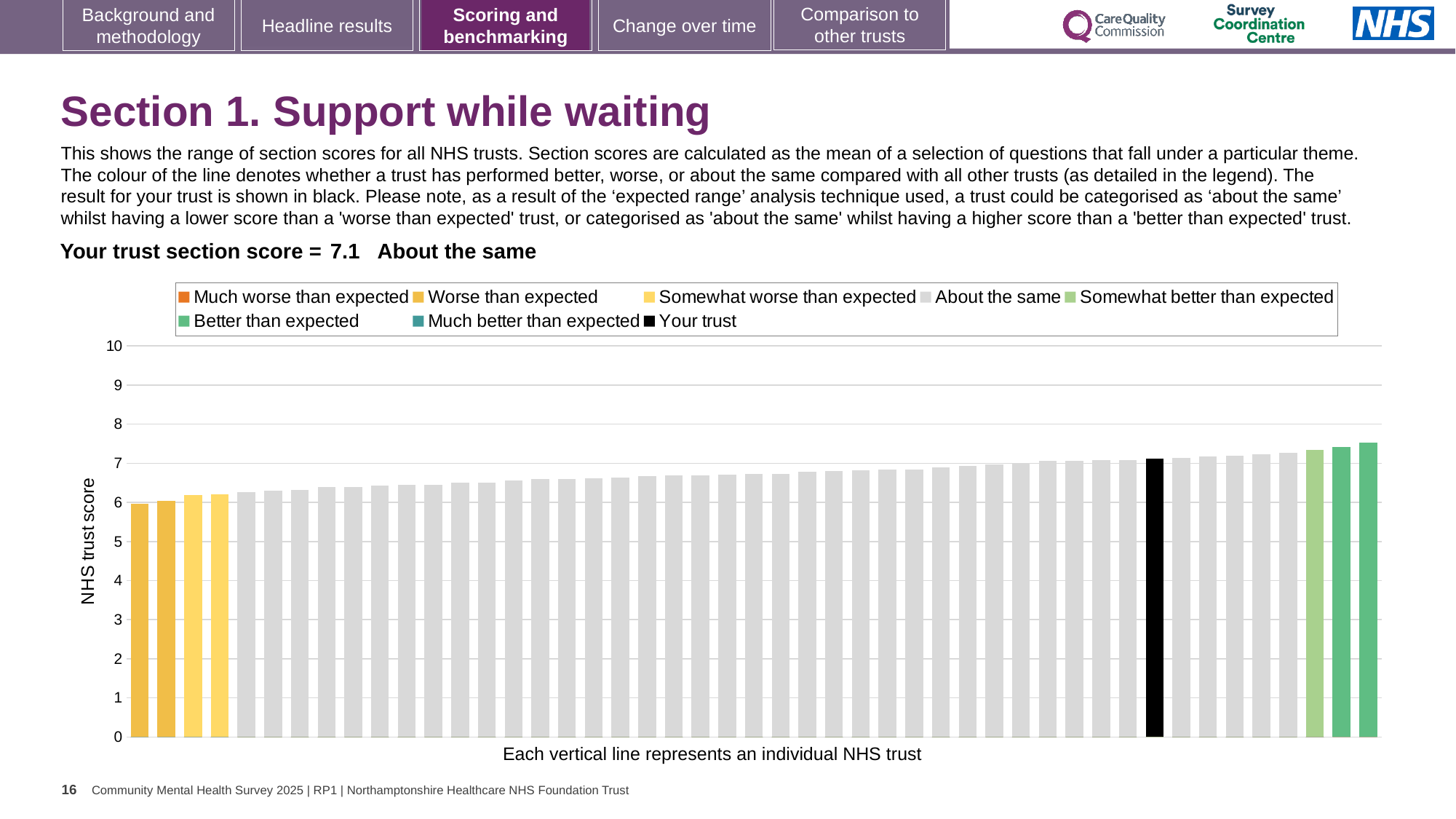
How many bars are coloured green (better than expected)? 2 What kind of chart is shown on the slide? bar chart What colour is the bar representing your trust? black Is the value of the tallest bar greater or less than 7? greater Do the bar values rise or fall from left to right along the x axis? rise How many entries does the chart legend list? 8 What is your trust's section score for Support while waiting? 7.1 Is the value of the tallest bar greater or less than 8? less What is the label on the vertical axis of the chart? NHS trust score Is the value of the lowest bar greater or less than 7? less Which category is your trust's section score placed in? About the same Is your trust's bar higher or lower than the tallest bar on the chart? lower